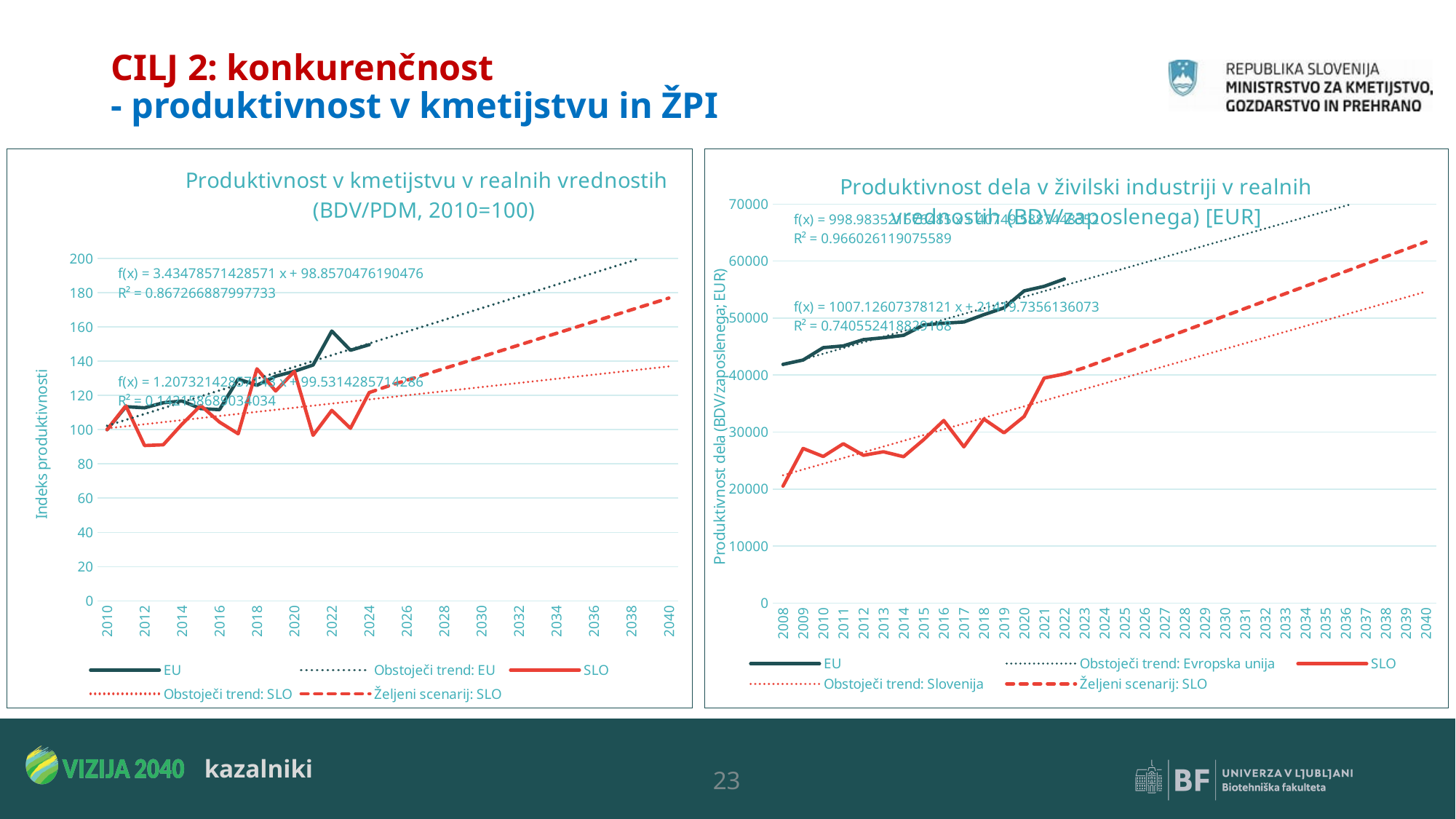
In the right chart, is the SLO value for 2017 greater or less than 30000? less How many series does the legend of the left chart list? 5 What is the y-axis label of the left chart? Indeks produktivnosti In the right chart, is the EU value for 2022 greater or less than 50000? greater What kind of chart is the left chart, 'Produktivnost v kmetijstvu v realnih vrednostih'? line chart In the left chart, which series has the larger value in 2024, EU or SLO? EU In the left chart, is the EU value for 2022 greater or less than 140? greater In the right chart, which series has the larger value in 2022, EU or SLO? EU How many series does the legend of the right chart, 'Produktivnost dela v živilski industriji', list? 5 In the left chart, does the EU series generally rise or fall from 2010 to 2024? rise